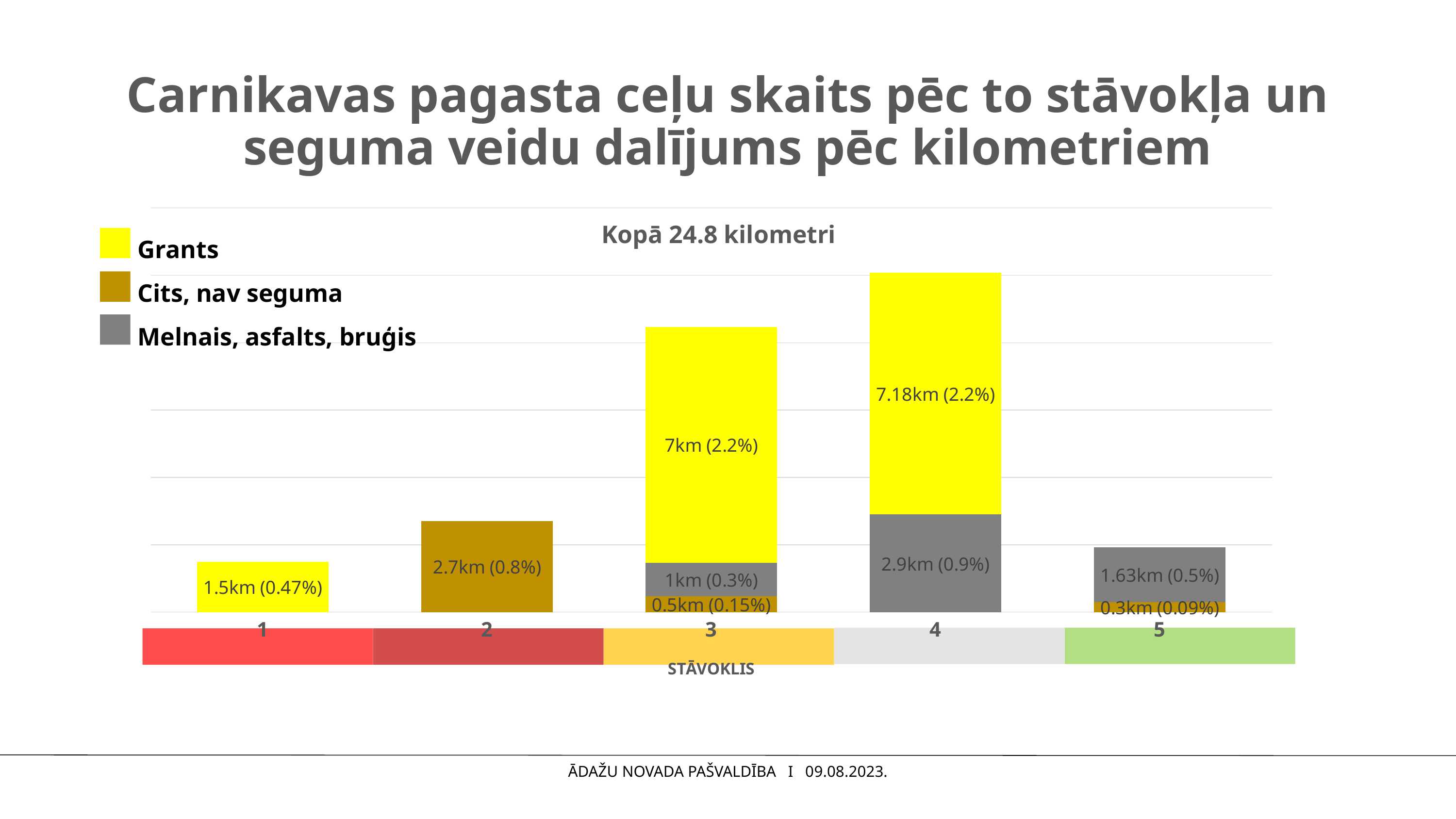
What is the total length of the stacked bar for condition category 3? 8.5km What is the value of Cits, nav seguma for condition category 2? 2.7km (0.8%) What is the value of Melnais, asfalts, bruģis for condition category 5? 1.63km (0.5%) What is the value of Grants for condition category 4? 7.18km (2.2%) Which condition category has the tallest stacked bar? 4 How many condition categories (stāvoklis) are shown on the x axis? 5 What is the value of Cits, nav seguma for condition category 3? 0.5km (0.15%) What kind of chart is shown on the slide? Stacked bar chart How many series does the legend list? 3 Which is larger: Grants in category 1 or Cits, nav seguma in category 2? Cits, nav seguma in category 2 What is the difference in kilometres between Melnais, asfalts, bruģis in category 4 and in category 3? 1.9km What total length in kilometres is stated above the chart? Kopā 24.8 kilometri